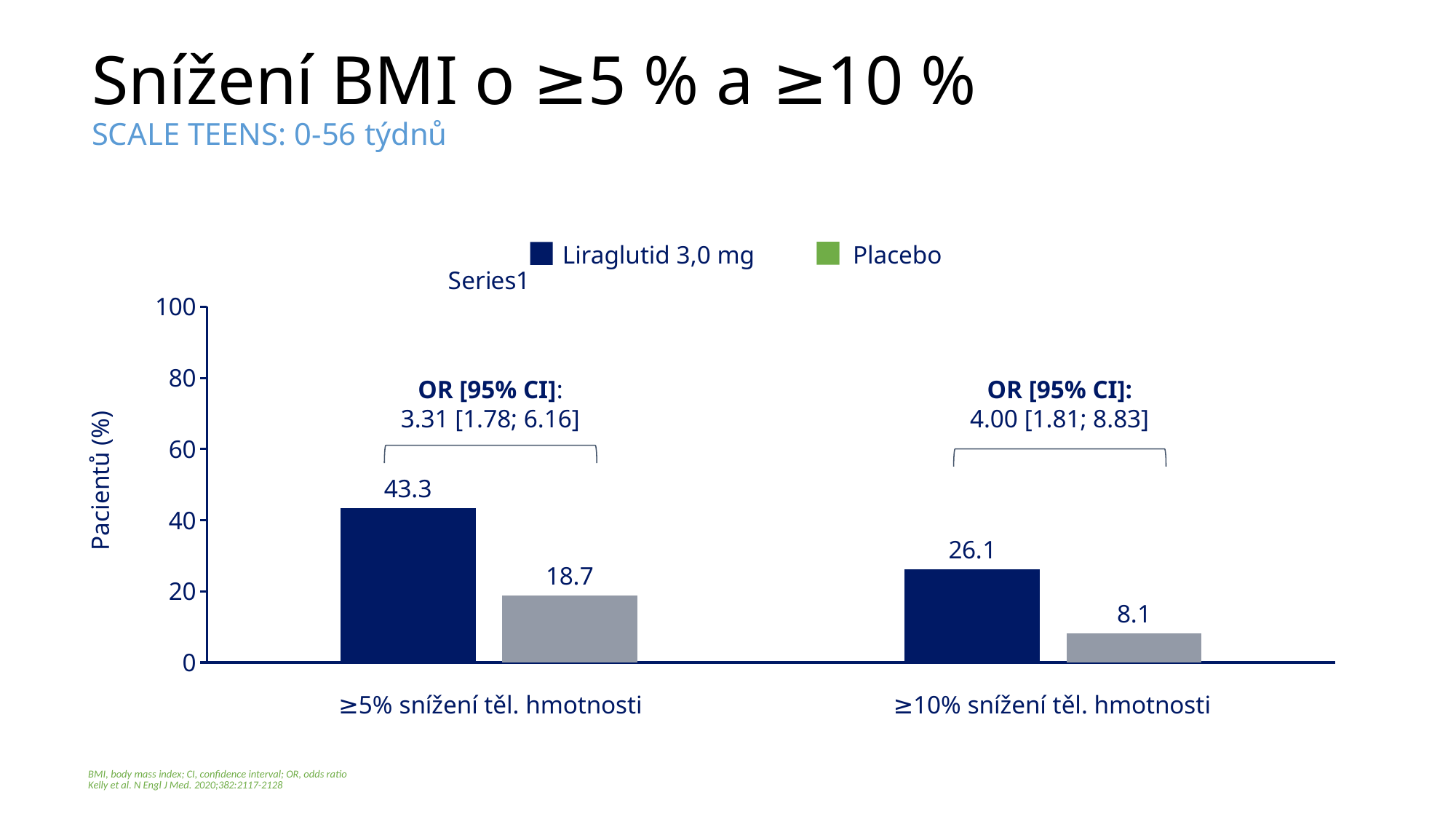
Which bar in the chart has the lowest value? Placebo, ≥10% snížení těl. hmotnosti What is the label of the y axis of the chart? Pacientů (%) What type of chart is shown on the slide? Bar chart What is the difference between the Liraglutid 3,0 mg and Placebo values for ≥10% snížení těl. hmotnosti? 18.0 What is the difference between the Liraglutid 3,0 mg and Placebo values for ≥5% snížení těl. hmotnosti? 24.6 What is the Liraglutid 3,0 mg value for ≥10% snížení těl. hmotnosti? 26.1 Which bar in the chart has the highest value? Liraglutid 3,0 mg, ≥5% snížení těl. hmotnosti What percentage of patients on Liraglutid 3,0 mg achieved a ≥5% snížení těl. hmotnosti? 43.3 Which is larger: the Placebo value for ≥5% snížení těl. hmotnosti or the Liraglutid 3,0 mg value for ≥10% snížení těl. hmotnosti? Liraglutid 3,0 mg for ≥10% snížení těl. hmotnosti How many categories are shown on the x axis of the chart? 2 What percentage of patients on Placebo achieved a ≥10% snížení těl. hmotnosti? 8.1 What is the Placebo value for ≥5% snížení těl. hmotnosti? 18.7